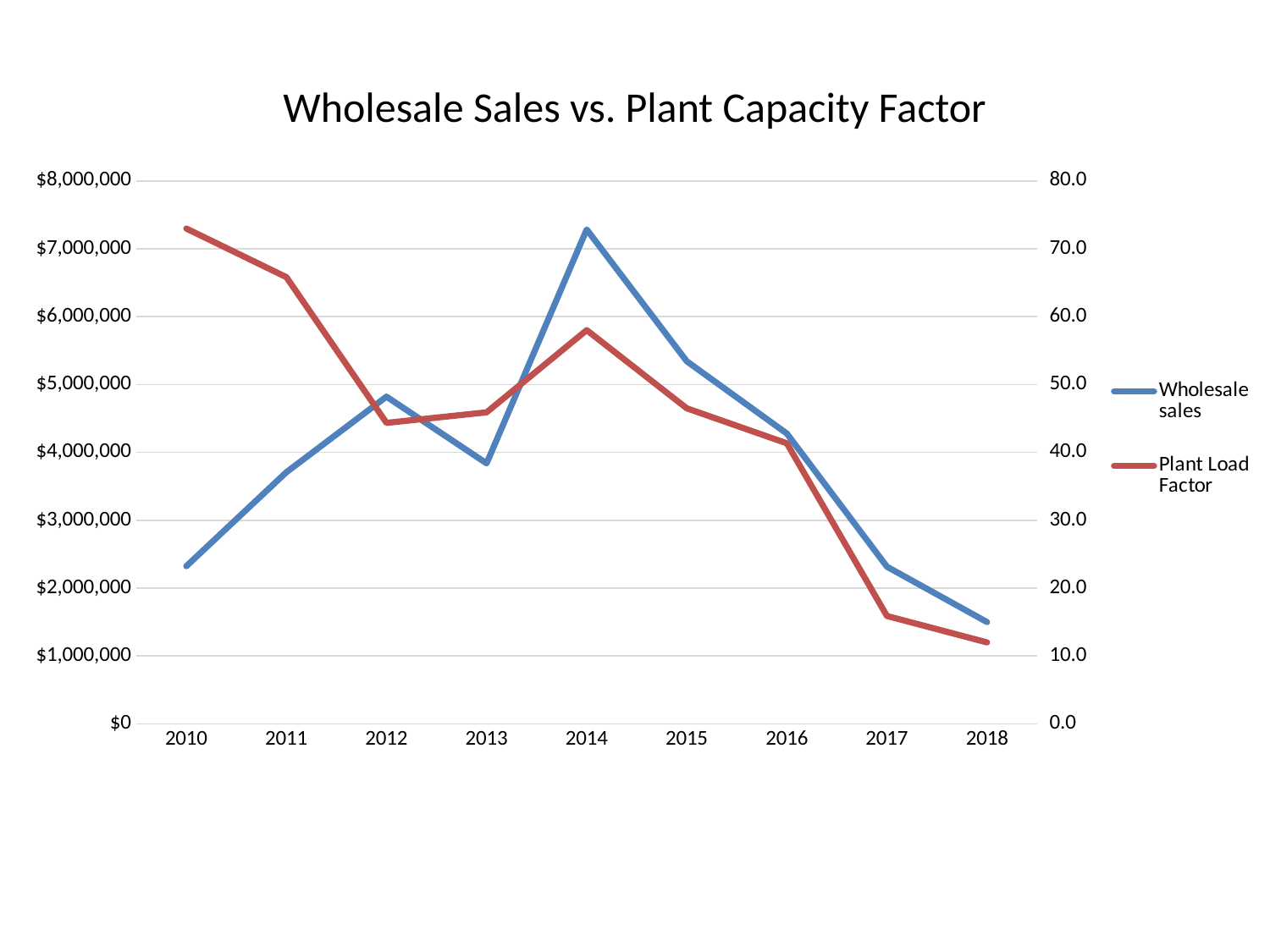
What kind of chart is shown on the slide? Line chart In which year is Wholesale sales highest? 2014 How many series does the legend list? 2 Is the value for Plant Load Factor in 2010 greater or less than 70.0? greater What is the title of the chart? Wholesale Sales vs. Plant Capacity Factor Is the value for Plant Load Factor in 2017 greater or less than 20.0? less In which year is Wholesale sales lowest? 2018 Is the value for Wholesale sales in 2014 greater or less than $7,000,000? greater Does the Plant Load Factor rise or fall from 2014 to 2018? Fall Which is larger, Wholesale sales in 2012 or in 2013? 2012 In which year is the Plant Load Factor highest? 2010 How many years are plotted along the x axis? 9